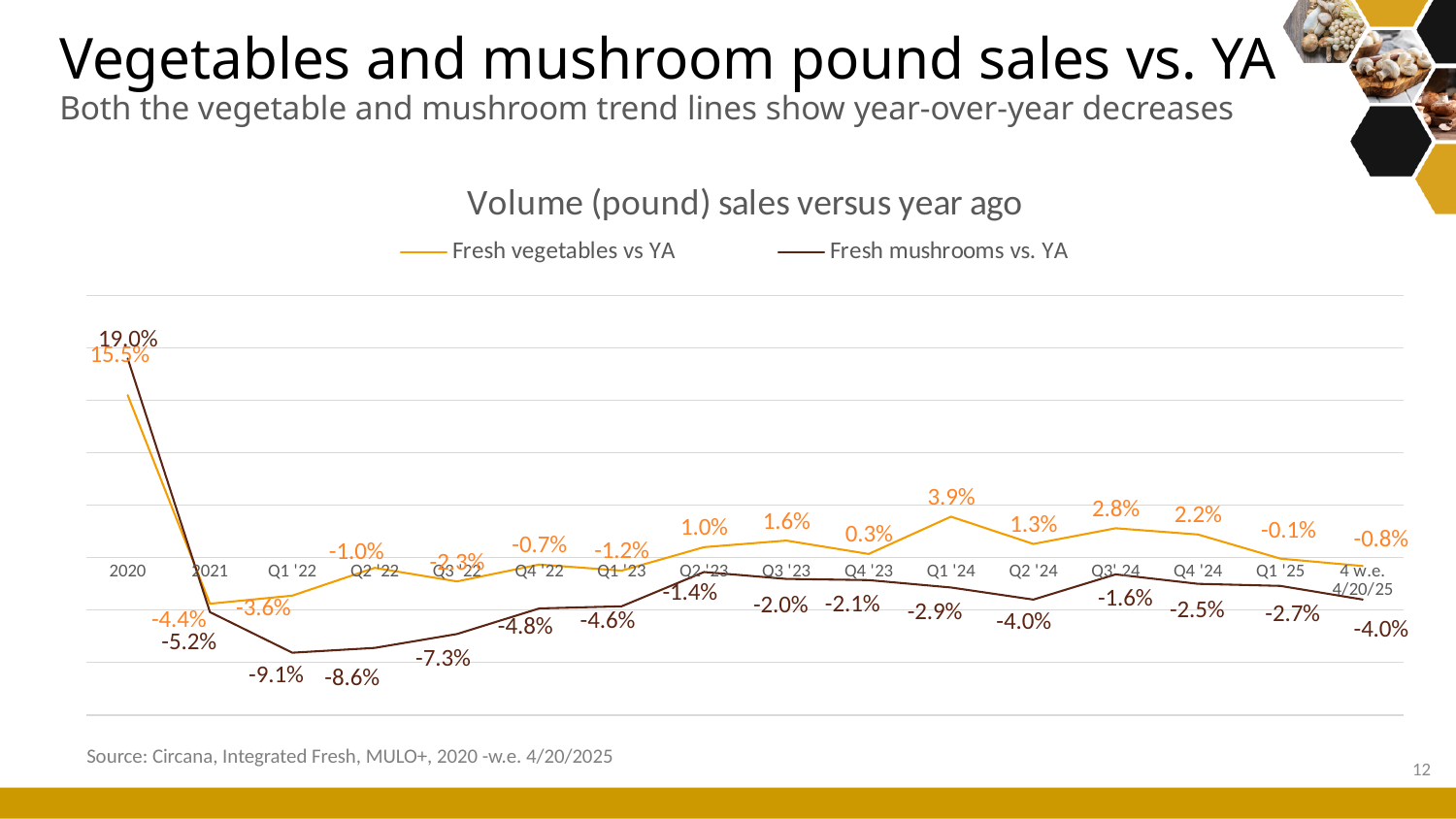
In which period is the Fresh vegetables vs YA value highest? 2020 How many series does the chart legend list? 2 What is the value for Fresh mushrooms vs. YA in Q1 '22? -9.1% What is the value for Fresh vegetables vs YA in Q1 '24? 3.9% What kind of chart is shown on the slide? Line chart In Q3 '24, which series has the higher value, Fresh vegetables vs YA or Fresh mushrooms vs. YA? Fresh vegetables vs YA What is the value for Fresh mushrooms vs. YA for the 4 w.e. 4/20/25 period? -4.0% In Q1 '24, what is the difference between the Fresh vegetables vs YA value and the Fresh mushrooms vs. YA value? 6.8 percentage points How many time periods are plotted along the x axis of the chart? 16 In which period is the Fresh mushrooms vs. YA value lowest? Q1 '22 Does the Fresh mushrooms vs. YA line rise or fall from Q1 '22 to Q2 '23? Rise What is the value for Fresh vegetables vs YA in Q4 '22? -0.7%